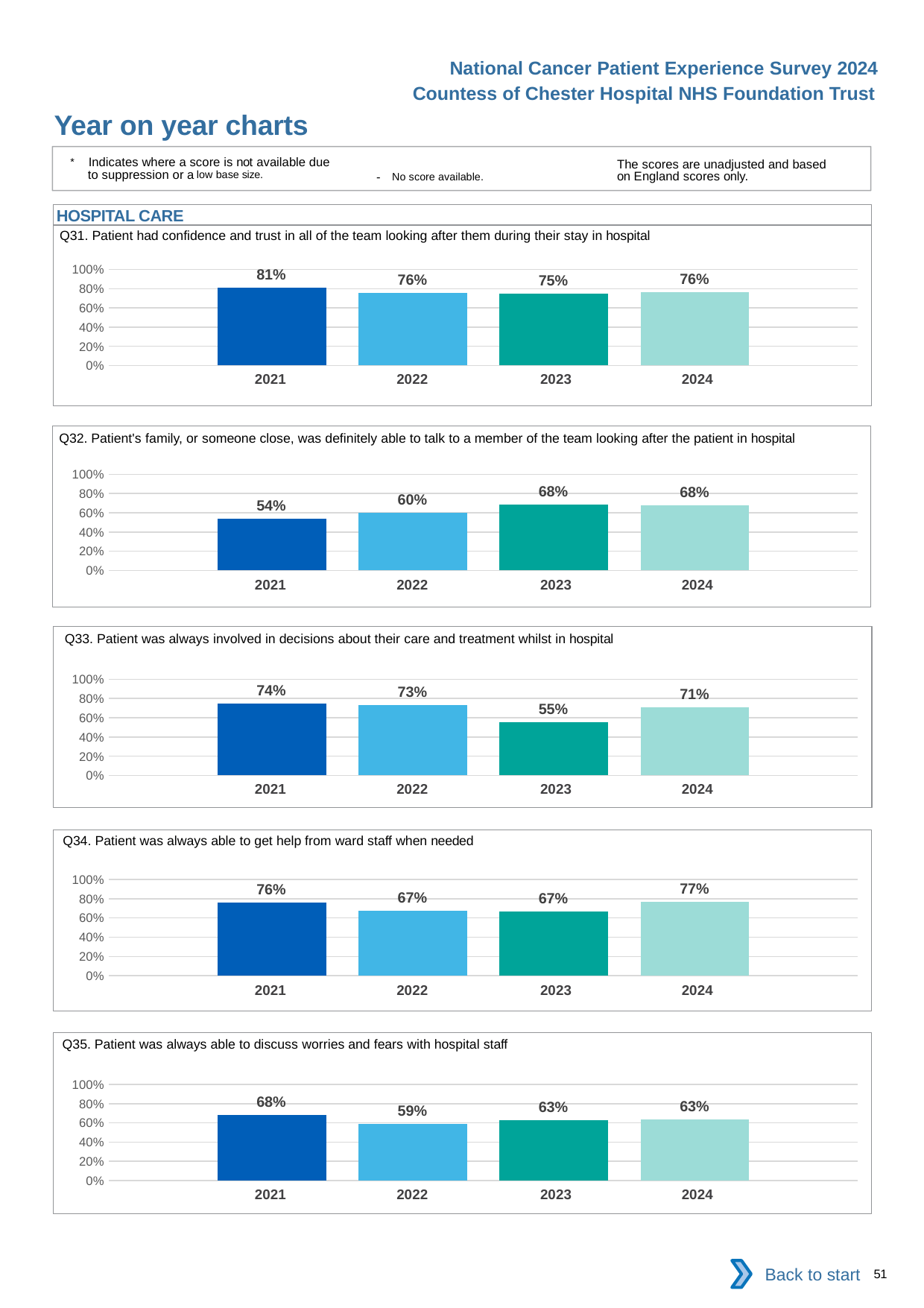
How many charts are shown on the slide? 5 In the Q34 chart, which year has the highest value? 2024 In the Q33 chart, is the value for 2023 greater or less than 60%? less In the Q32 chart, is the value for 2022 larger or smaller than the value for 2021? larger In the Q32 chart, do the values rise or fall from 2021 to 2023? rise In the Q33 chart, what is the difference between the 2021 and 2023 values? 19% How many years are shown in the Q31 chart? 4 In the Q35 chart, what is the value for 2022? 59% In the Q32 chart, which year has the lowest value? 2021 In the Q31 chart, what is the value for 2021? 81% What type of chart is the Q34 chart? bar chart In the Q35 chart, what is the difference between the 2021 and 2022 values? 9%